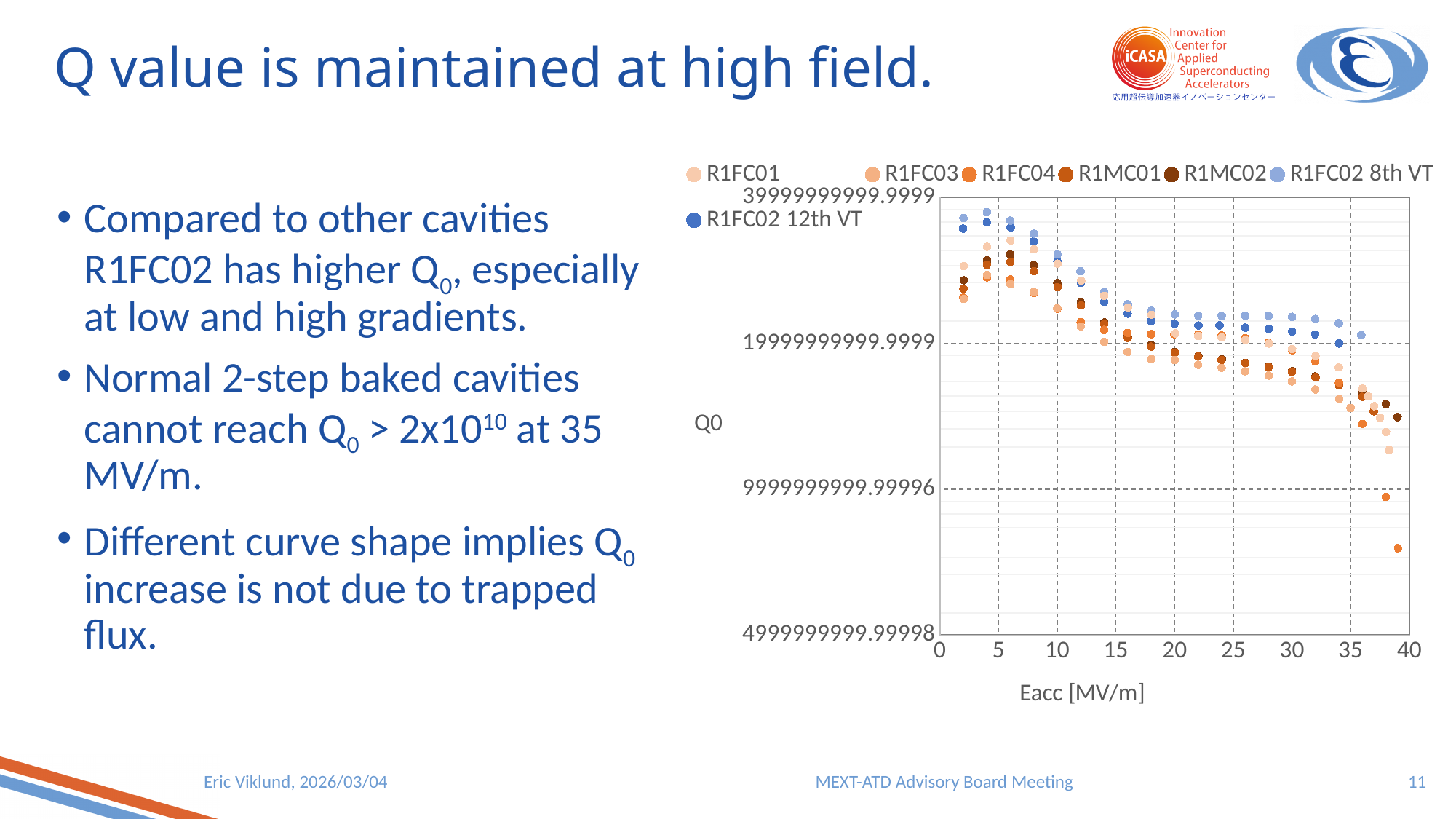
Is the Q0 value for R1FC02 8th VT at about 35 MV/m greater or less than 19999999999.9999? greater Is the lowest Q0 value for R1FC04 (at the highest Eacc) greater or less than 9999999999.99996? less What kind of chart is shown on the slide? scatter chart How many series does the chart legend list? 7 Overall, do the Q0 values rise or fall as Eacc increases along the x axis? fall What is the maximum value shown on the x axis of the chart? 40 Is the Q0 value for R1FC02 12th VT at about 2 MV/m greater or less than 19999999999.9999? greater What is the label of the y axis of the chart? Q0 What is the label of the x axis of the chart? Eacc [MV/m] At about 35 MV/m, which series has the higher Q0: R1FC02 8th VT or R1FC04? R1FC02 8th VT Which series reaches the lowest Q0 value on the chart? R1FC04